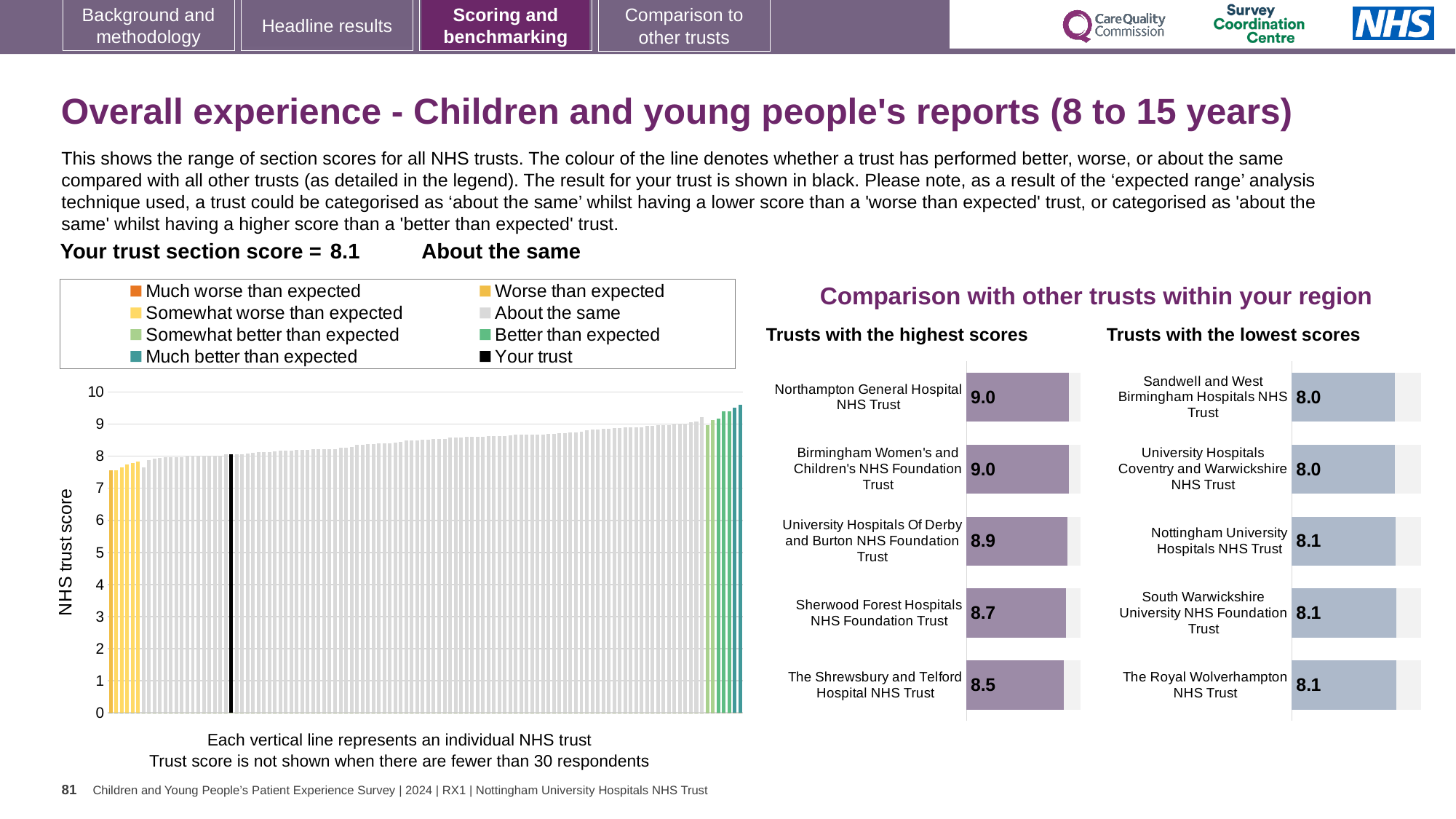
How many trusts are listed in the 'Trusts with the lowest scores' chart? 5 In the 'Trusts with the highest scores' chart, what is the score for Sherwood Forest Hospitals NHS Foundation Trust? 8.7 In the 'NHS trust score' chart on the left, is the value of the leftmost bar greater or less than 8? less In the 'Trusts with the lowest scores' chart, what is the score for Nottingham University Hospitals NHS Trust? 8.1 In the 'Trusts with the highest scores' chart, what is the score for Northampton General Hospital NHS Trust? 9.0 In the 'Trusts with the highest scores' chart, which trust has the lowest score? The Shrewsbury and Telford Hospital NHS Trust In the 'NHS trust score' chart on the left, do the bar values rise or fall from left to right along the x axis? Rise How many entries does the legend of the 'NHS trust score' chart on the left list? 8 What kind of chart is the 'NHS trust score' chart on the left of the slide? Bar chart In the 'Trusts with the highest scores' chart, what is the difference between the scores of Northampton General Hospital NHS Trust and The Shrewsbury and Telford Hospital NHS Trust? 0.5 In the 'Trusts with the lowest scores' chart, what is the score for Sandwell and West Birmingham Hospitals NHS Trust? 8.0 In the 'Trusts with the lowest scores' chart, which has the larger score: Nottingham University Hospitals NHS Trust or University Hospitals Coventry and Warwickshire NHS Trust? Nottingham University Hospitals NHS Trust